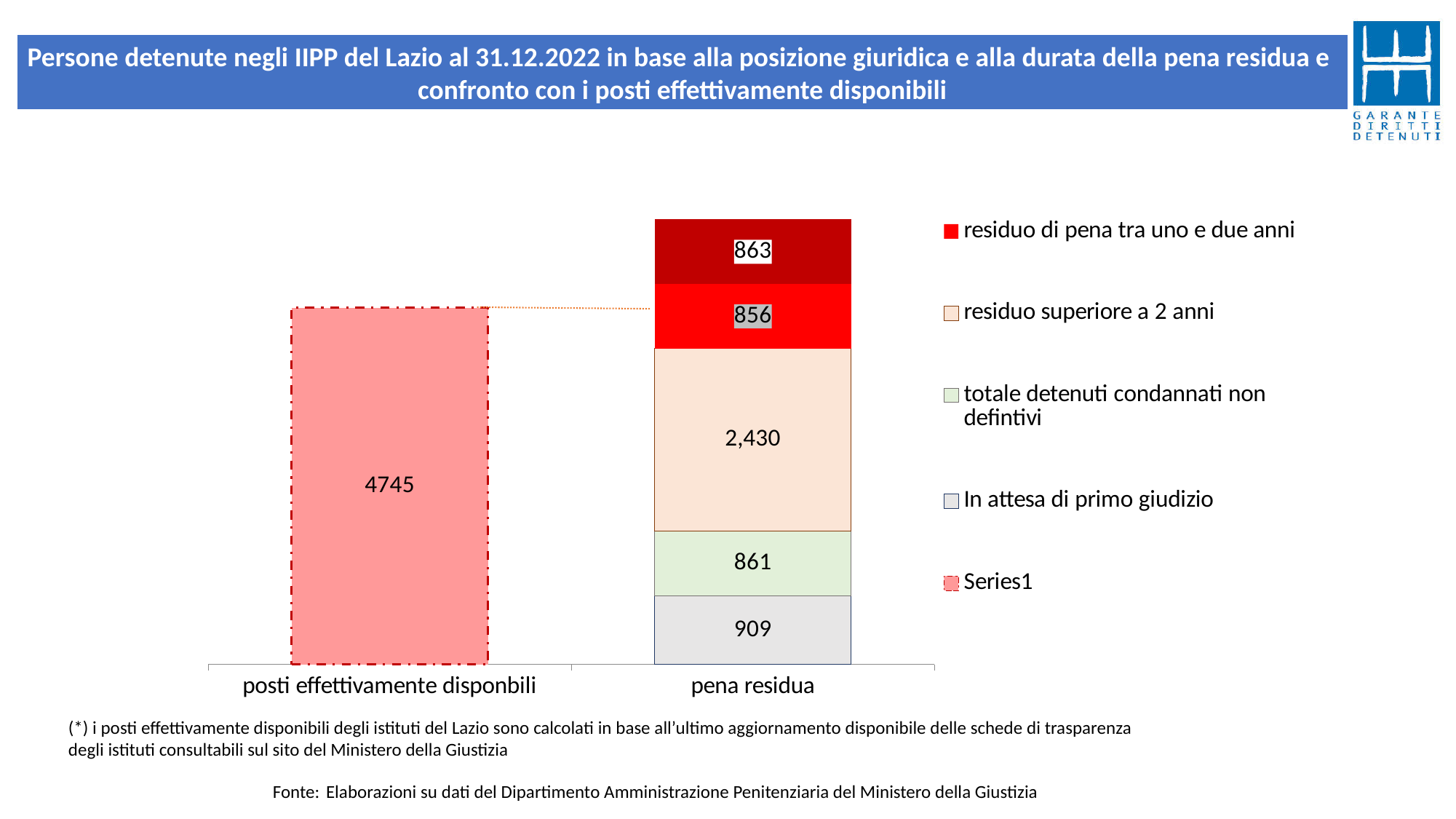
What is the difference between the "residuo superiore a 2 anni" segment and the "In attesa di primo giudizio" segment? 1521 What is the total of all segments in the "pena residua" stacked bar? 5919 Which is larger: the "residuo superiore a 2 anni" segment or the "totale detenuti condannati non defintivi" segment? residuo superiore a 2 anni In the "pena residua" bar, what is the value of the "In attesa di primo giudizio" segment? 909 In the "pena residua" bar, what is the value of the "totale detenuti condannati non defintivi" segment? 861 What is the value shown for "posti effettivamente disponbili"? 4745 In the "pena residua" bar, what is the value of the "residuo superiore a 2 anni" segment? 2,430 In the "pena residua" bar, what is the value of the "residuo di pena tra uno e due anni" segment? 856 Which segment of the "pena residua" bar is the largest? residuo superiore a 2 anni How many entries does the chart legend list? 5 What is the value printed on the topmost (dark red) segment of the "pena residua" bar? 863 How many categories are shown on the x axis of the chart? 2